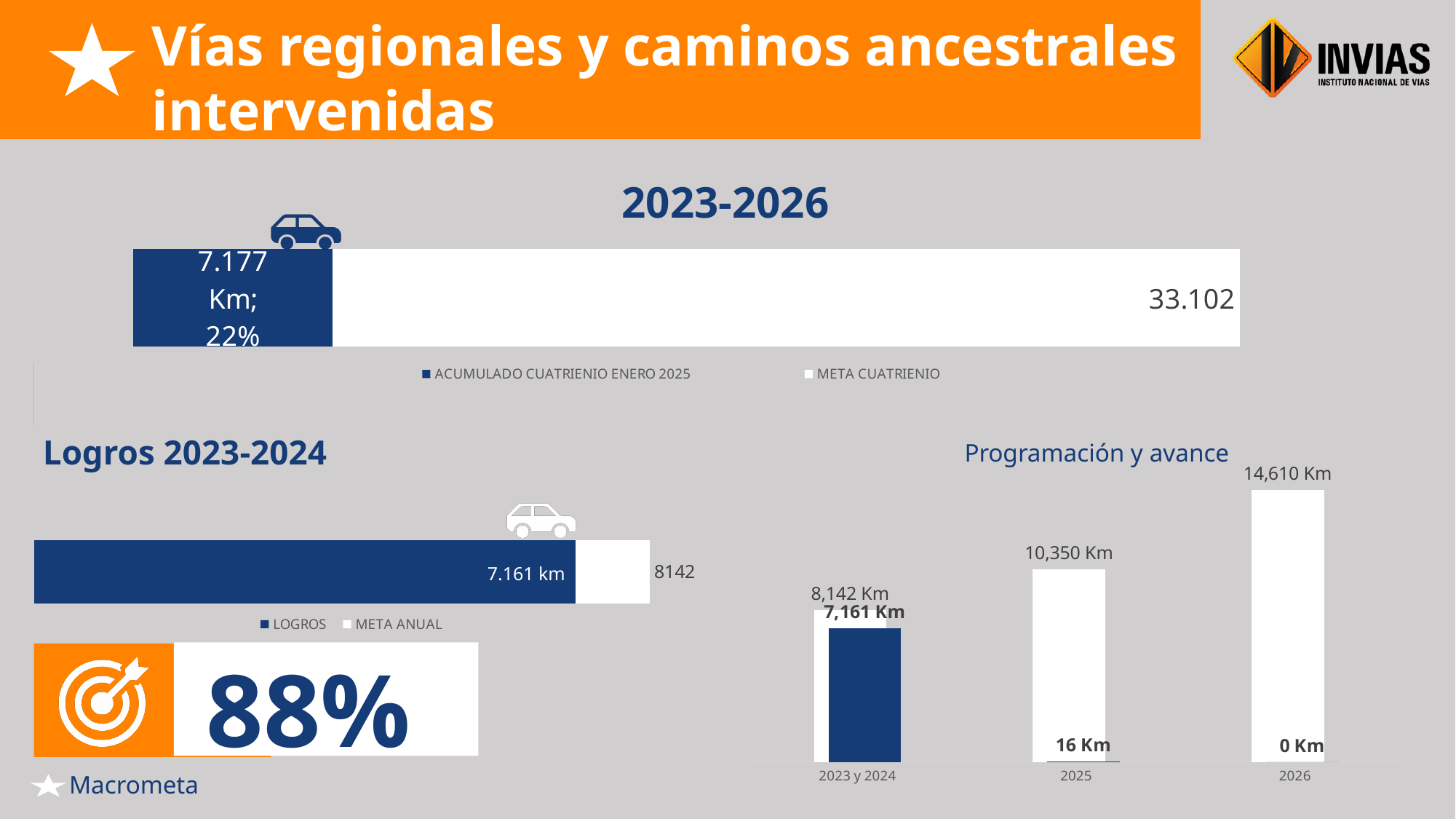
In the 'Logros 2023-2024' chart, which is larger, LOGROS or META ANUAL? META ANUAL In the 'Logros 2023-2024' chart, what value is shown for META ANUAL? 8142 In the 'Programación y avance' chart, how many categories are shown on the x axis? 3 In the '2023-2026' chart, how many series does the legend list? 2 In the 'Programación y avance' chart, what is the advance value (blue bar) for 2025? 16 Km In the 'Programación y avance' chart, which category has the highest programmed (white bar) value? 2026 What kind of chart is the '2023-2026' chart? Bar chart In the 'Programación y avance' chart, what is the programmed value (white bar) for 2026? 14,610 Km In the 'Programación y avance' chart, do the programmed (white bar) values rise or fall from 2023 y 2024 to 2026? Rise In the '2023-2026' chart, what value is shown for ACUMULADO CUATRIENIO ENERO 2025? 7.177 Km; 22% In the '2023-2026' chart, what value is shown for META CUATRIENIO? 33.102 In the 'Logros 2023-2024' chart, what value is shown for LOGROS? 7.161 km